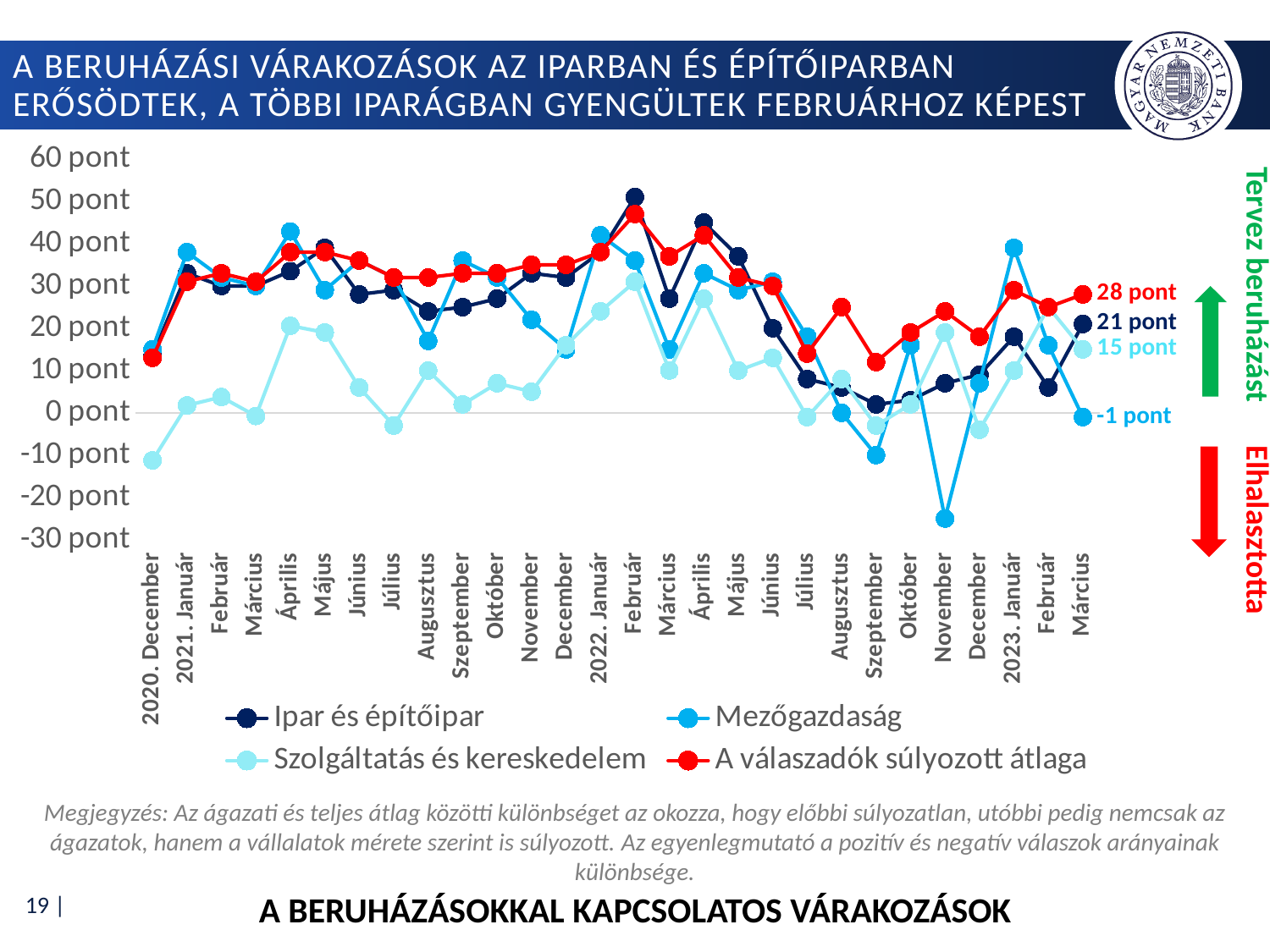
Which is larger in 2023. Március: Ipar és építőipar or Szolgáltatás és kereskedelem? Ipar és építőipar Is the value for Ipar és építőipar in 2022. Február greater or less than 40 pont? greater What is the value for A válaszadók súlyozott átlaga in 2023. Március? 28 pont How many series does the legend list? 4 What is the value for Mezőgazdaság in 2023. Március? -1 pont What is the value for Szolgáltatás és kereskedelem in 2023. Március? 15 pont Which series has the highest value in 2023. Március? A válaszadók súlyozott átlaga What is the value for Ipar és építőipar in 2023. Március? 21 pont Is the value for Mezőgazdaság in 2022. November greater or less than -20 pont? less Which series has the lowest value in 2023. Március? Mezőgazdaság What kind of chart is shown on the slide? Line chart What is the difference between A válaszadók súlyozott átlaga and Ipar és építőipar in 2023. Március? 7 pont